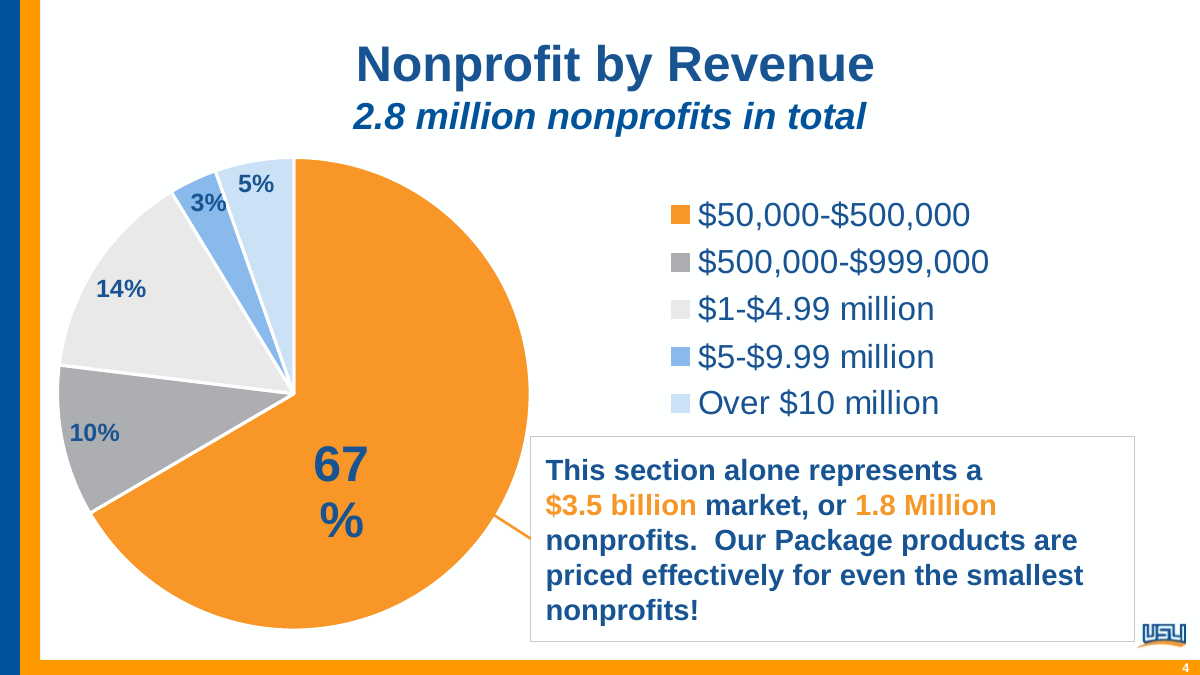
Which is larger, the Over $10 million slice or the $5-$9.99 million slice? Over $10 million What share of the pie does the $50,000-$500,000 category represent? 67% Which category has the largest slice of the pie? $50,000-$500,000 What type of chart is shown on the slide? Pie chart What is the value for the $500,000-$999,000 category? 10% What is the value for the $1-$4.99 million category? 14% What is the title of the chart? Nonprofit by Revenue How many categories does the pie chart show? 5 What is the value for the Over $10 million category? 5% Which category has the smallest slice of the pie? $5-$9.99 million What is the value for the $5-$9.99 million category? 3% What is the difference between the $1-$4.99 million slice and the $500,000-$999,000 slice? 4%